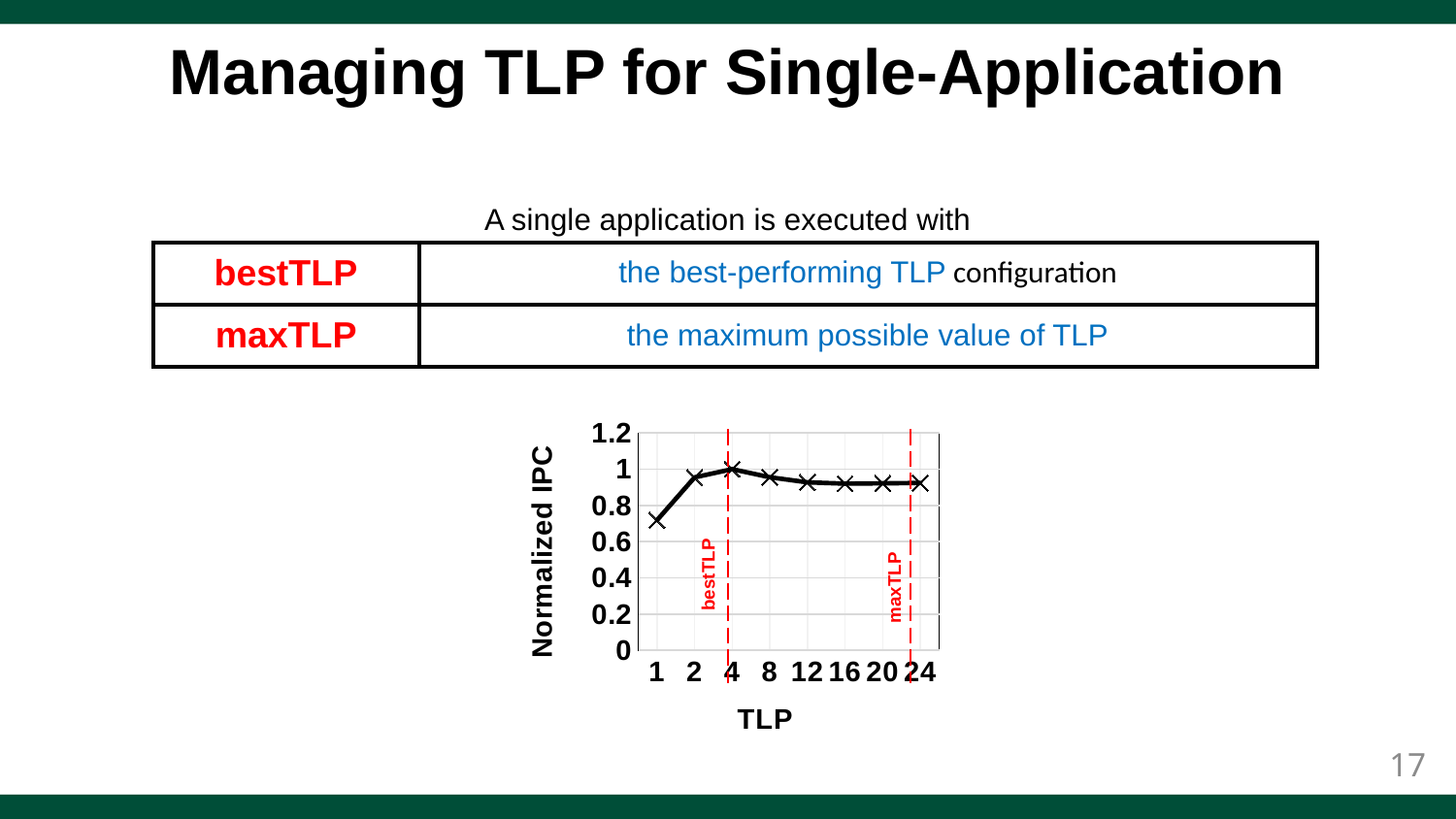
Is the Normalized IPC at TLP 12 greater or less than 1.2? less How many data points are plotted on the line? 8 Is the Normalized IPC at TLP 24 greater or less than 0.8? greater At which TLP value is the Normalized IPC highest? 4 What is the label of the x axis? TLP Is the Normalized IPC at TLP 1 greater or less than 0.6? greater What kind of chart is shown on the slide? line chart What is the label of the y axis? Normalized IPC Which has a higher Normalized IPC, TLP 1 or TLP 2? TLP 2 At which TLP value is the Normalized IPC lowest? 1 Does the Normalized IPC rise or fall from TLP 1 to TLP 4? rise